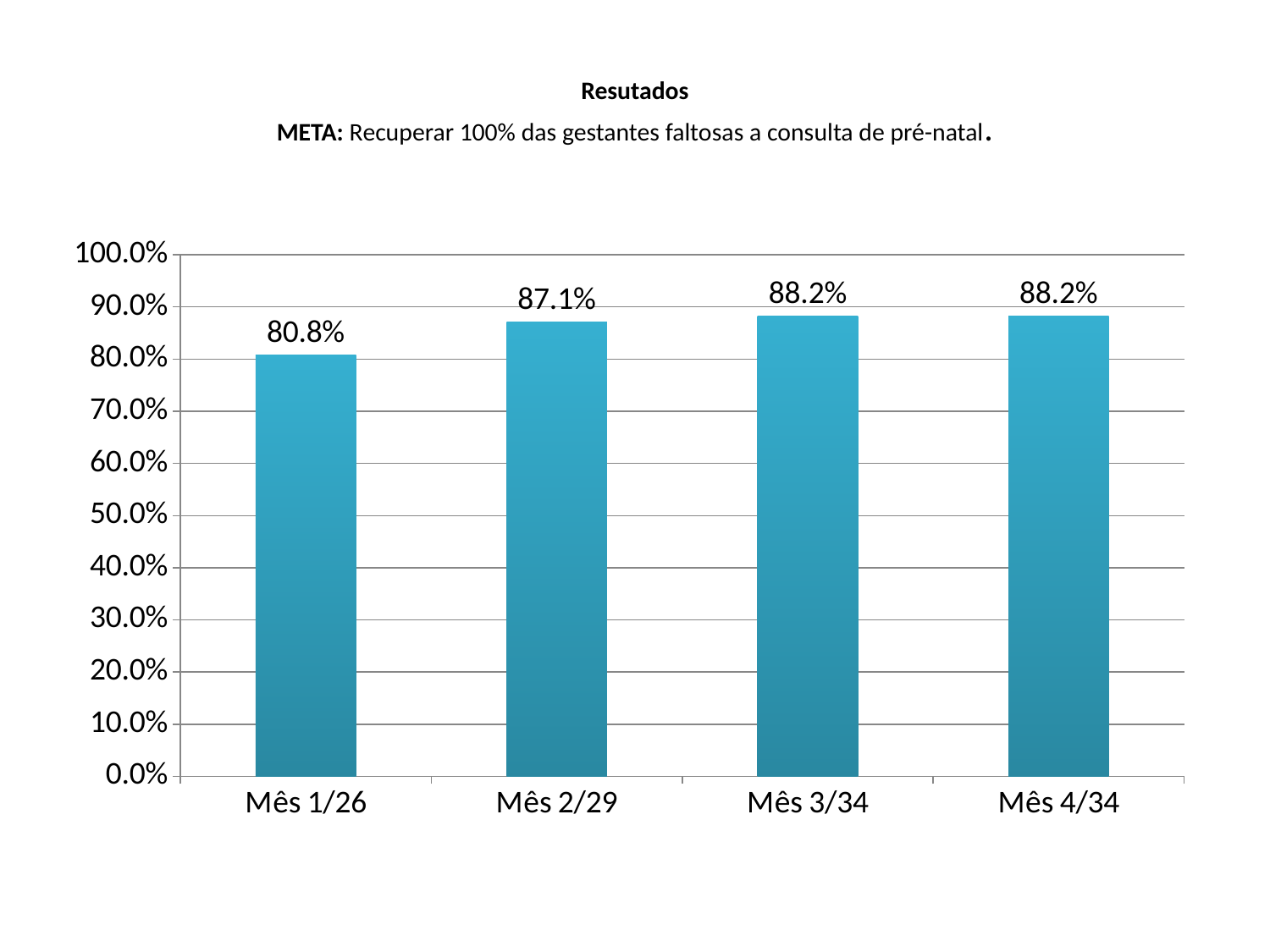
What is the difference between the values for Mês 2/29 and Mês 1/26? 6.3% Which is larger, the value for Mês 2/29 or the value for Mês 1/26? Mês 2/29 Do the values rise or fall from Mês 1/26 to Mês 3/34? rise What is the value for Mês 4/34? 88.2% What is the value for Mês 3/34? 88.2% What is the value for Mês 2/29? 87.1% Is the value for Mês 1/26 greater or less than 90%? less What is the value for Mês 1/26? 80.8% How many categories are shown on the x axis? 4 What kind of chart is shown on the slide? bar chart What is the difference between the values for Mês 3/34 and Mês 2/29? 1.1% Which category has the lowest value? Mês 1/26